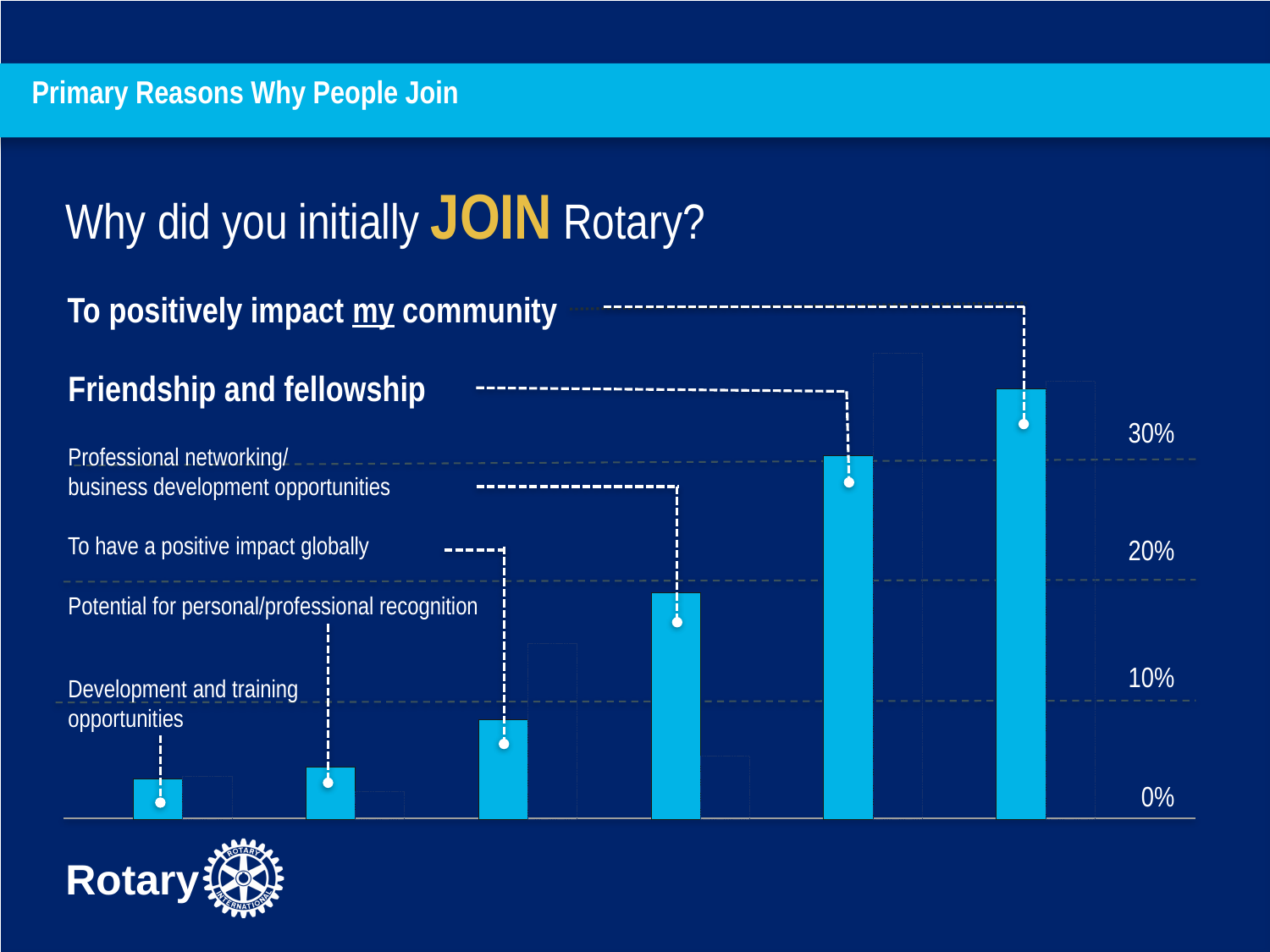
What kind of chart is shown on the slide? bar chart How many bars (reasons) are plotted in the chart? 6 Do the bar values rise or fall from left to right across the chart? rise Which is larger: the value for "Friendship and fellowship" or the value for "Professional networking/business development opportunities"? Friendship and fellowship What question does the chart answer, as written above it? Why did you initially JOIN Rotary? Which reason for joining has the highest bar? To positively impact my community Is the value for "To positively impact my community" greater or less than 30%? greater What is the highest percentage tick shown on the chart's axis? 30% Is the value for "To have a positive impact globally" greater or less than 10%? less Is the value for "Professional networking/business development opportunities" greater or less than 20%? less Which reason for joining has the lowest bar? Development and training opportunities